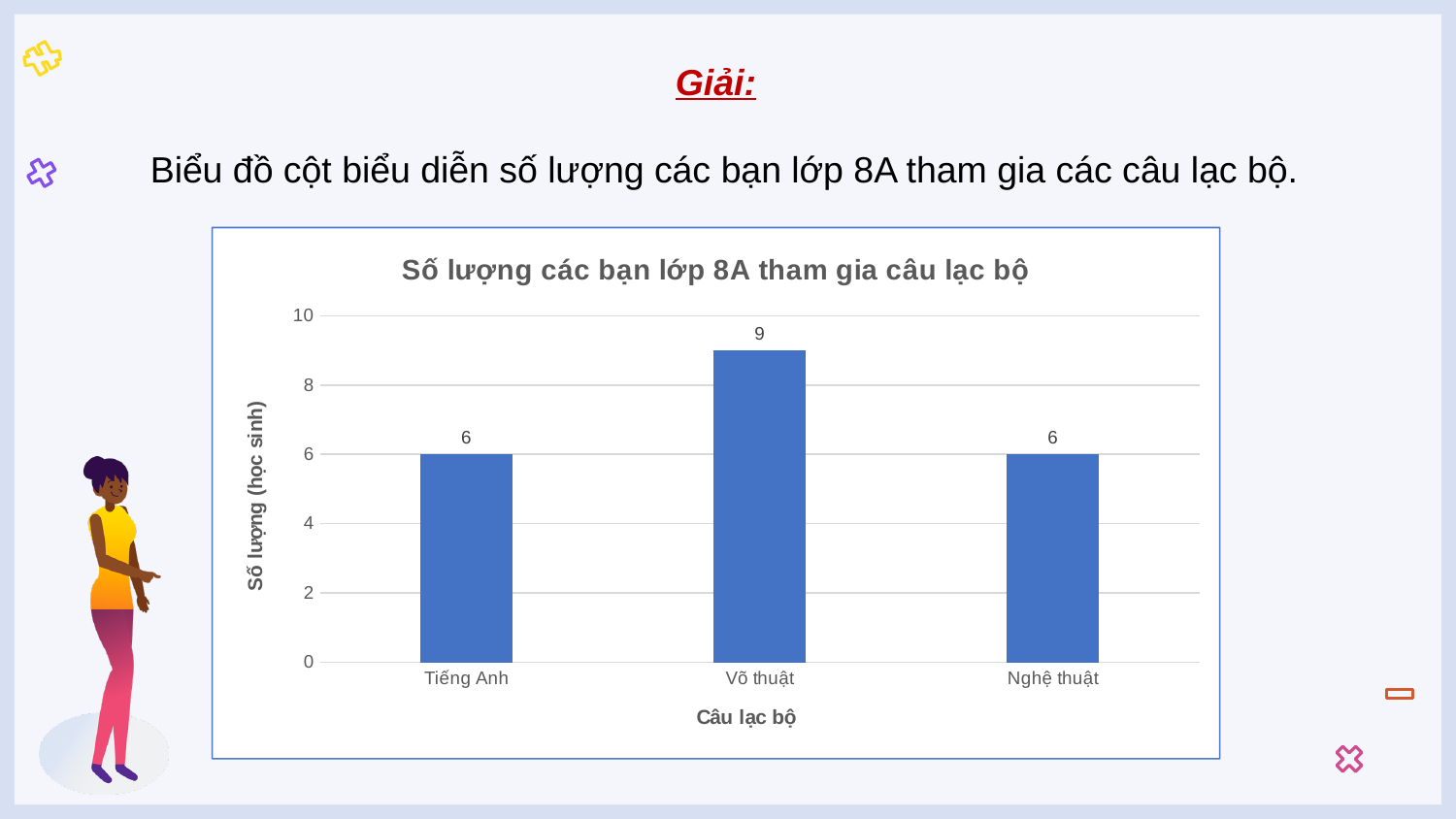
What kind of chart is shown on the slide? bar chart What is the label of the vertical axis? Số lượng (học sinh) What is the title of the chart? Số lượng các bạn lớp 8A tham gia câu lạc bộ What is the value for Nghệ thuật? 6 What is the value for Võ thuật? 9 Which is larger, the value for Võ thuật or the value for Nghệ thuật? Võ thuật What is the value for Tiếng Anh? 6 How many clubs are shown on the x axis? 3 What is the difference between the values for Võ thuật and Tiếng Anh? 3 Is the value for Võ thuật greater or less than 8? greater Which club has the highest number of students? Võ thuật What is the total number of students across all three clubs? 21